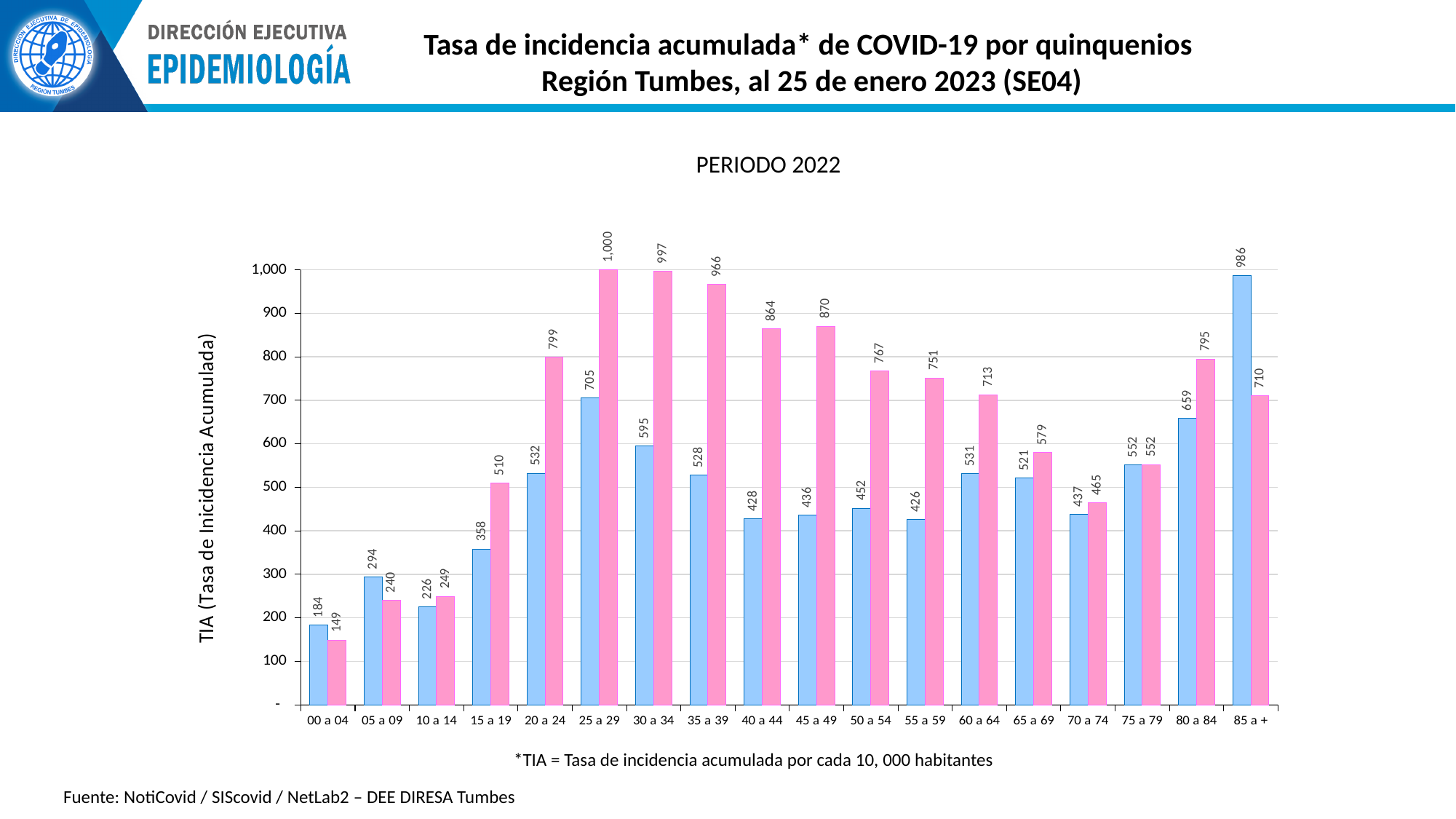
What kind of chart is shown on the slide? bar chart What is the value of the pink bar for the 00 a 04 age group? 149 Which is larger for the 85 a + age group, the blue bar or the pink bar? the blue bar Which age group has the highest blue bar? 85 a + Which age group has the highest pink bar? 25 a 29 What is the value of the blue bar for the 25 a 29 age group? 705 How many age groups are shown on the x axis? 18 What is the value of the pink bar for the 40 a 44 age group? 864 What is the difference between the pink bar and the blue bar for the 35 a 39 age group? 438 Which age group has the lowest blue bar? 00 a 04 Is the value of the pink bar for the 50 a 54 age group greater or less than 700? greater What is the title shown above the chart? PERIODO 2022